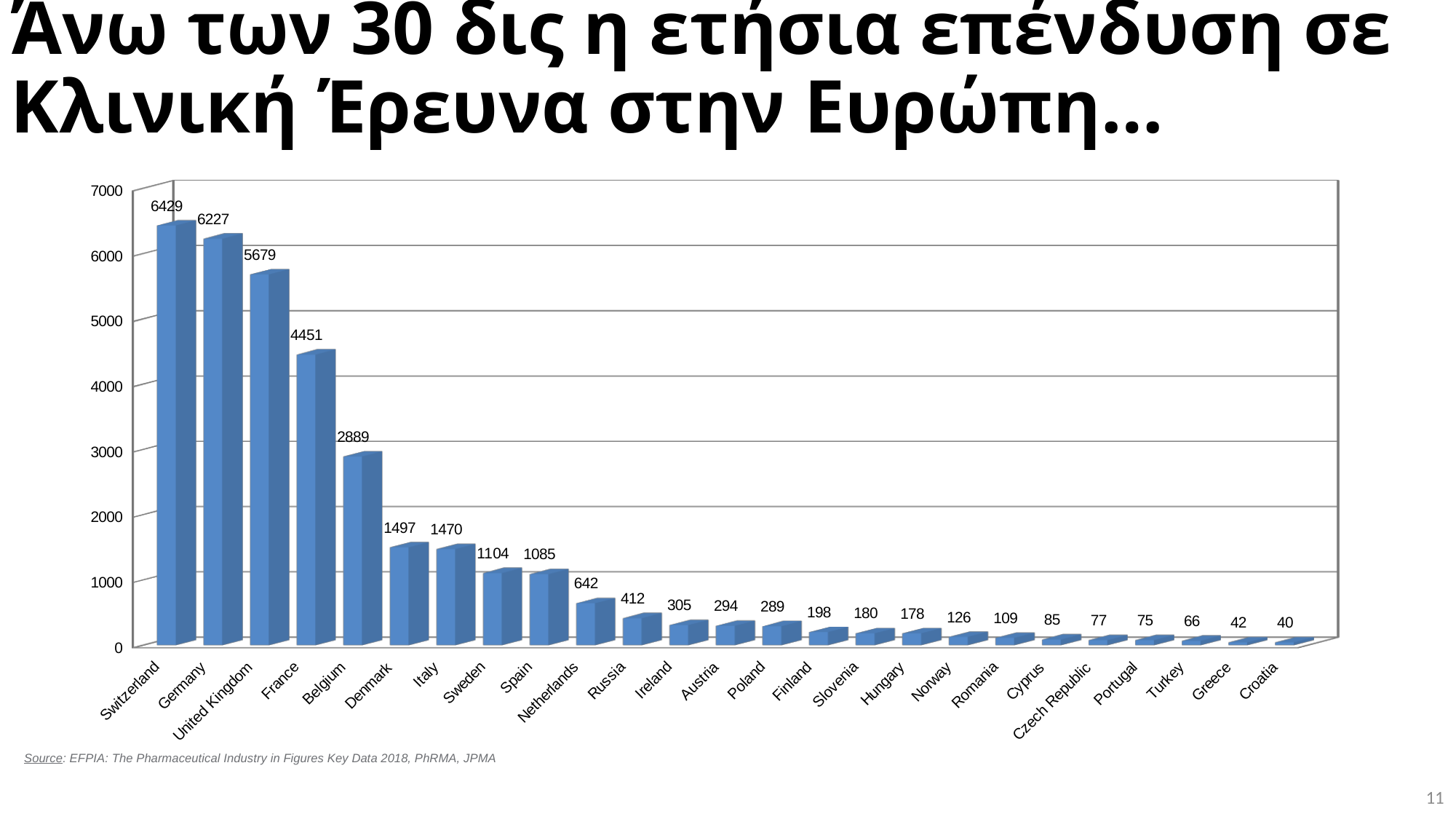
What is the value for Greece? 42 Is the value for United Kingdom greater or less than 5000? greater What kind of chart is shown on the slide? bar chart How many countries are shown in the chart? 25 Which country has the lowest value? Croatia What is the difference between the values for Switzerland and Germany? 202 What is the value for Switzerland? 6429 Do the values rise or fall from left to right along the x axis? fall What is the difference between the values for France and Belgium? 1562 What is the value for Netherlands? 642 Which is larger, the value for Denmark or the value for Italy? Denmark Which country has the highest value? Switzerland